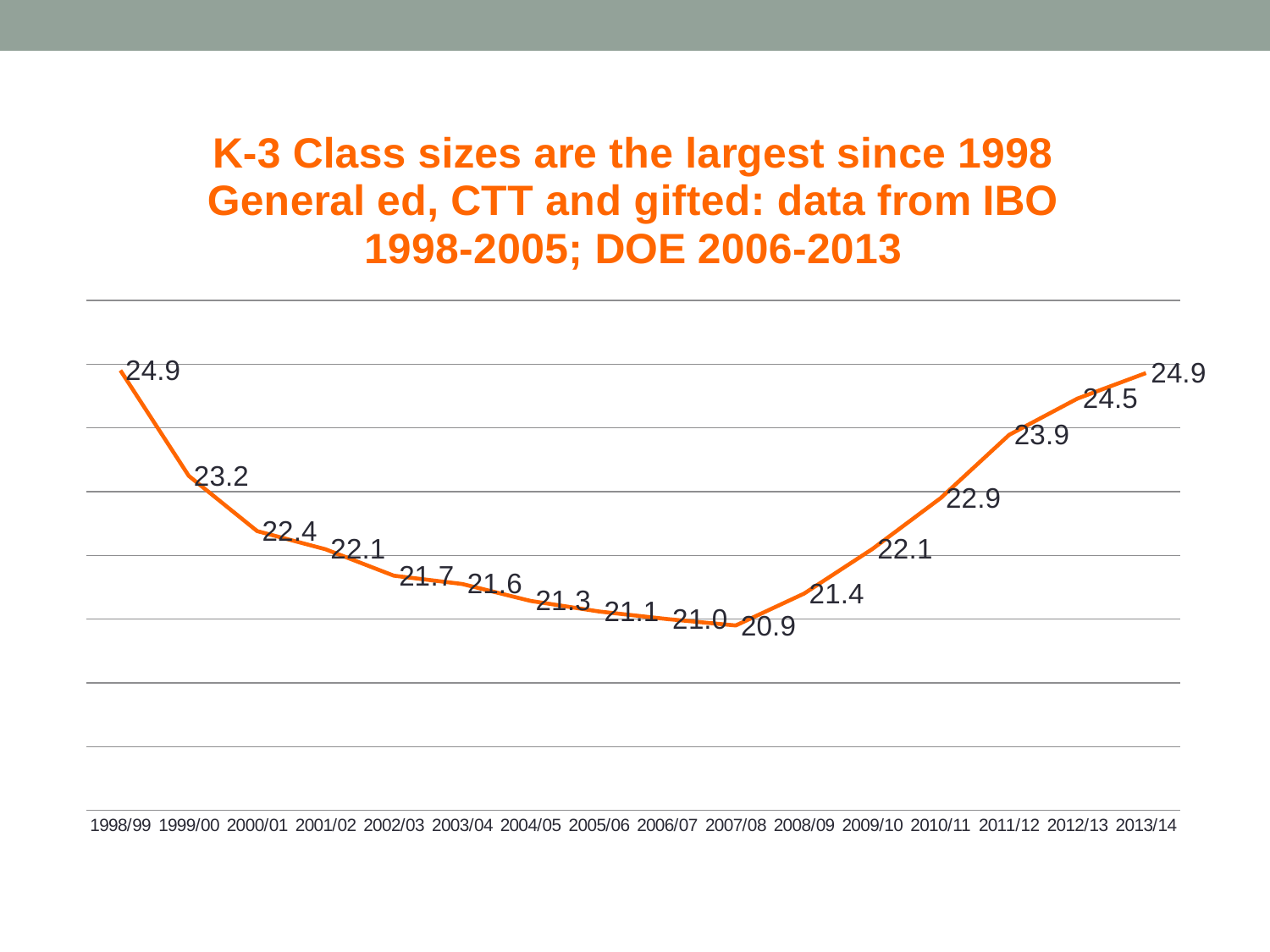
What is the highest value shown on the chart? 24.9 What is the difference between the values for 2013/14 and 2007/08? 4.0 What is the value plotted for 2003/04? 21.6 Which school year has the lowest value on the chart? 2007/08 Do the values rise or fall from 2007/08 to 2013/14? rise What is the difference between the values for 1999/00 and 2000/01? 0.8 What is the value plotted for 1998/99? 24.9 What is the value plotted for 2011/12? 23.9 What is the K-3 class size value for 2007/08? 20.9 Which is larger, the value for 2010/11 or the value for 2001/02? 2010/11 What type of chart is shown on the slide? line chart How many school years are plotted on the x axis? 16